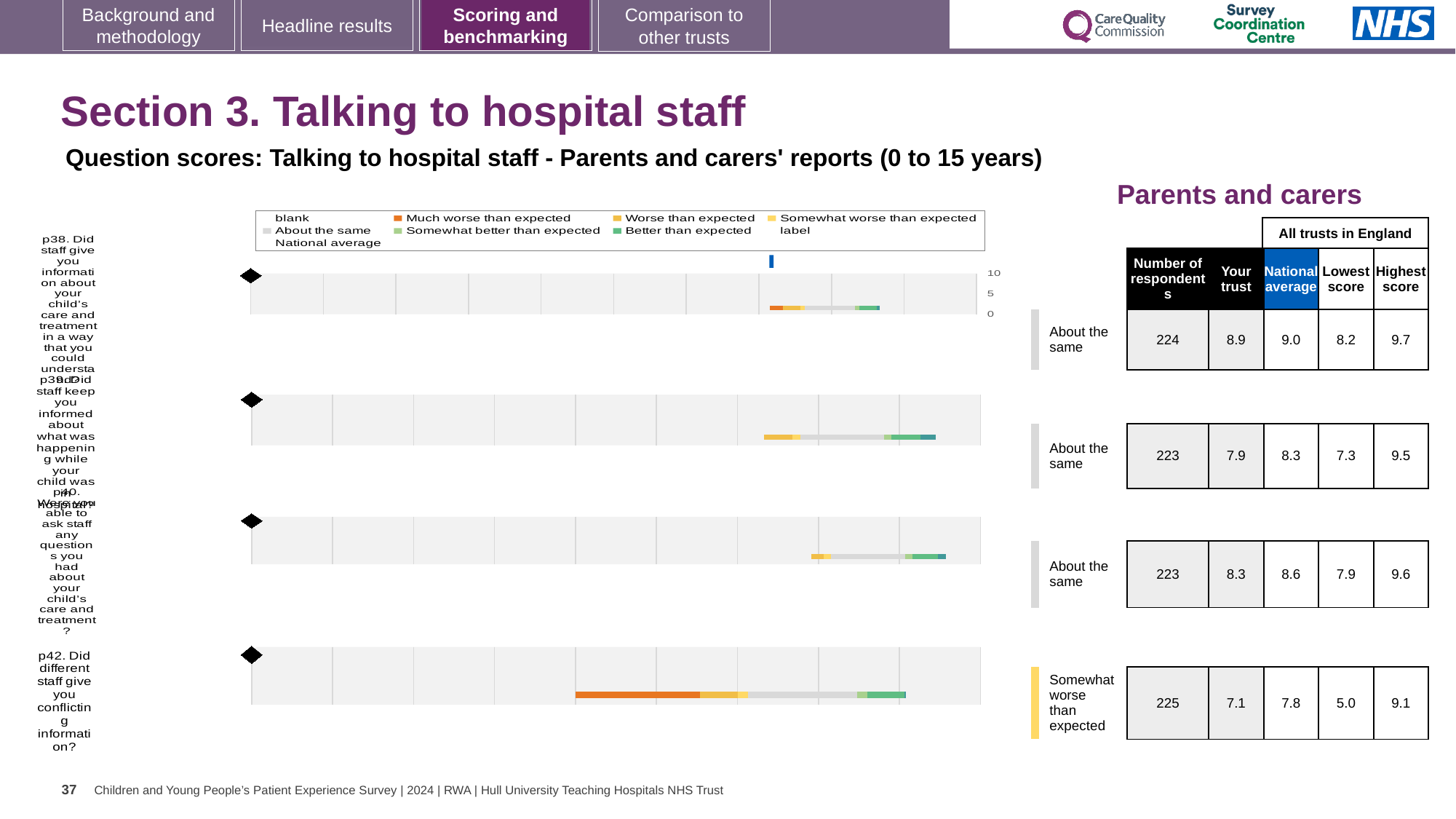
What kind of chart is used to show the question scores on this slide? bar chart How many entries does the chart legend list? 9 How many question charts (p38, p39, p40, p42) are shown on the slide? 4 Which question has the lowest 'Your trust' score? p42 What is the 'Your trust' score for p42 (Did different staff give you conflicting information?)? 7.1 For p42, what is the difference between the Highest score (9.1) and the Lowest score (5.0) across all trusts in England? 4.1 What benchmark category is shown for p42? Somewhat worse than expected For p38, what is the difference between the National average (9.0) and the 'Your trust' score (8.9)? 0.1 How many respondents answered p40 (Were you able to ask staff any questions you had about your child's care and treatment?)? 223 Which question has the highest 'Your trust' score? p38 For p39, which is larger: the 'Your trust' score or the National average? National average What is the National average score for p38 (Did staff give you information about your child's care and treatment in a way that you could understand?)? 9.0